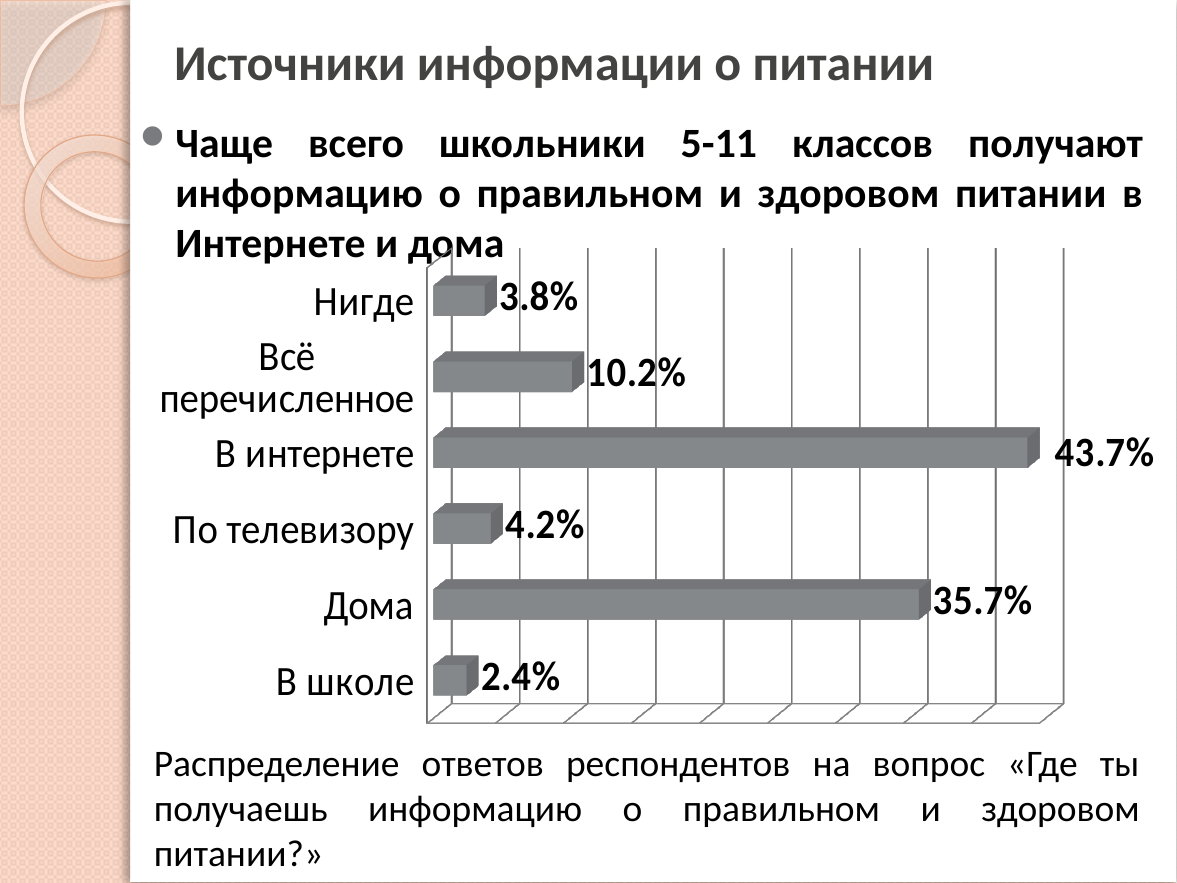
What kind of chart is shown on the slide? Bar chart What is the value for «Всё перечисленное»? 10.2% Which category has the highest value? В интернете Which is larger, the value for «По телевизору» or the value for «Нигде»? По телевизору What is the value for «В школе»? 2.4% What is the value for «Дома»? 35.7% What is the difference between the values for «Всё перечисленное» and «Нигде»? 6.4% Which category has the lowest value? В школе What is the difference between the values for «В интернете» and «Дома»? 8.0% What is the title of the slide containing the chart? Источники информации о питании How many categories are shown in the chart? 6 What is the value for «В интернете»? 43.7%